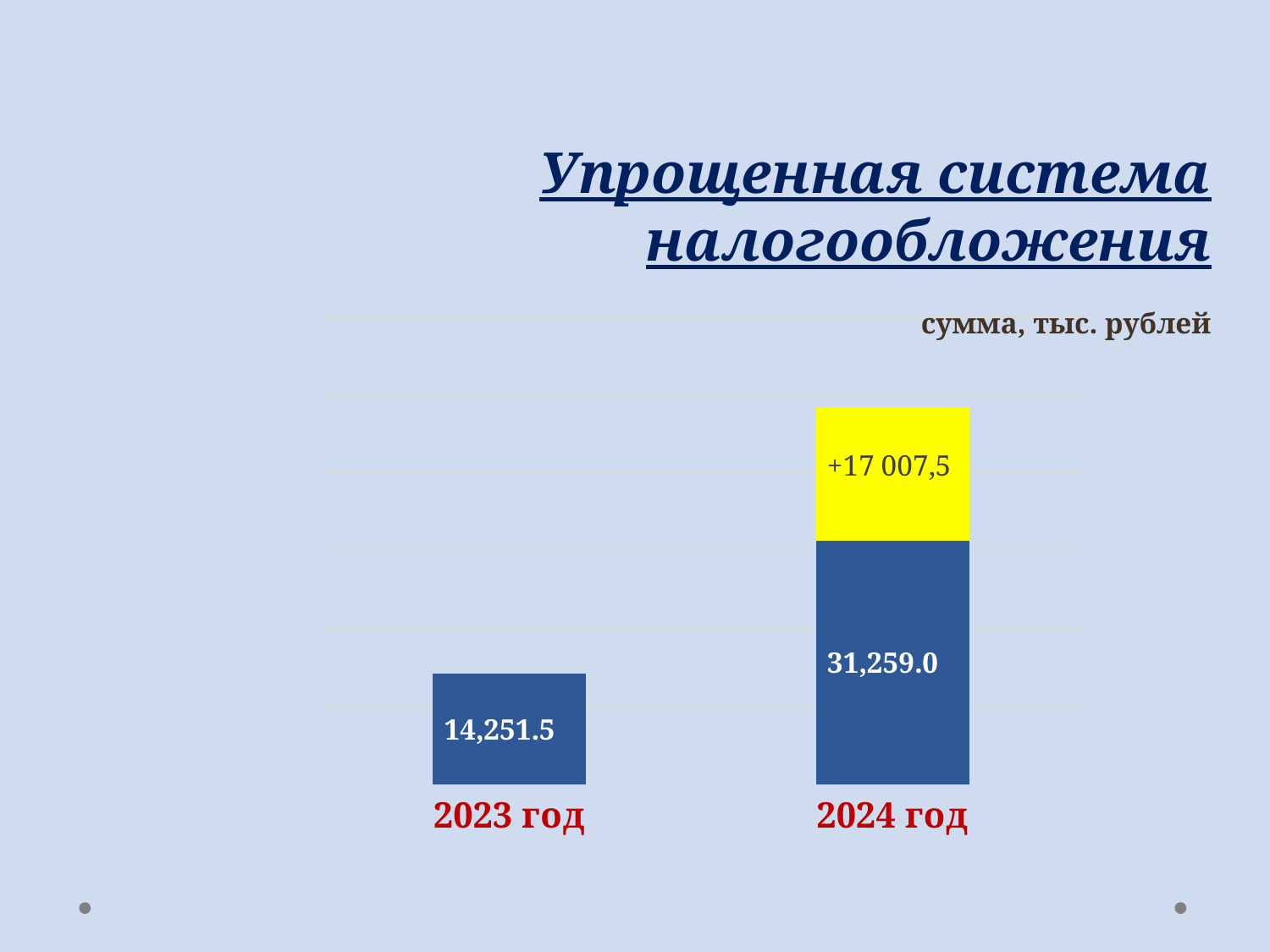
What is the value for 2024 год? 31,259.0 What is the value for 2023 год? 14,251.5 What kind of chart is shown on the slide? Bar chart In what units are the values on the chart given? тыс. рублей What increase is printed on the yellow segment of the 2024 год bar? +17 007,5 What is the difference between the values for 2024 год and 2023 год? 17,007.5 Which year has the lowest value? 2023 год Which year has the highest value? 2024 год Which is larger, the value for 2023 год or for 2024 год? 2024 год Do the values rise or fall from 2023 год to 2024 год? Rise How many years are shown on the chart? 2 What is the title of the slide? Упрощенная система налогообложения